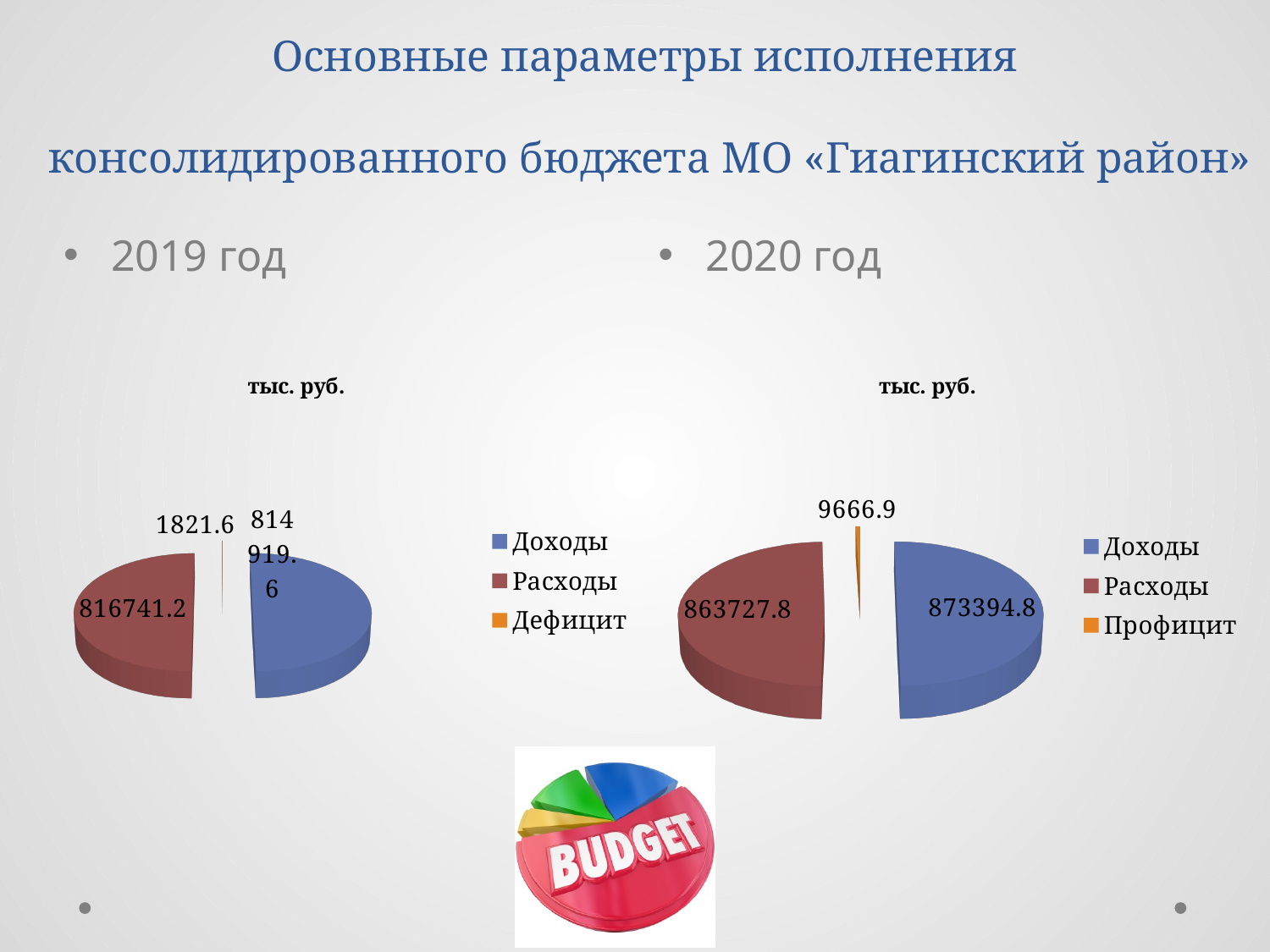
In the 2019 год chart, which category has the smallest value? Дефицит In the 2020 год chart, which is larger, Доходы or Расходы? Доходы In the 2020 год chart, which category has the largest value? Доходы What unit is shown in the title of both charts? тыс. руб. In the 2019 год chart, what is the value for Дефицит? 1821.6 In the 2020 год chart, what is the value for Профицит? 9666.9 In the 2020 год chart, what is the value for Доходы? 873394.8 In the 2019 год chart, what is the value for Расходы? 816741.2 What kind of chart is used for the 2019 год data? pie chart In the 2019 год chart, what is the difference between Расходы and Доходы? 1821.6 In the 2020 год chart, what is the value for Расходы? 863727.8 How many entries does the legend of the 2020 год chart list? 3